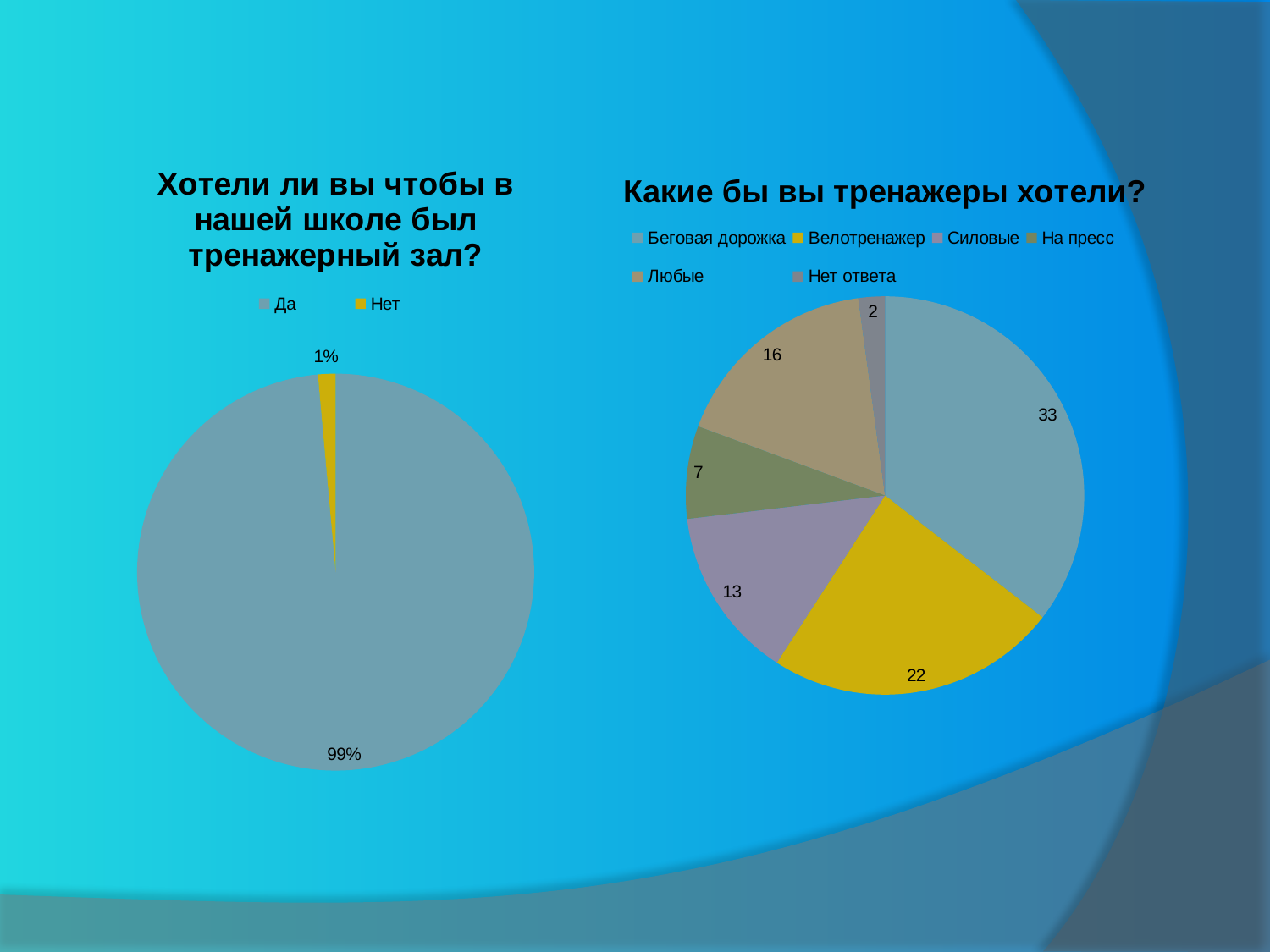
In the right chart, what is the difference between the values for "Беговая дорожка" and "Силовые"? 20 In the chart titled "Какие бы вы тренажеры хотели?", what is the value for "Велотренажер"? 22 In the chart titled "Какие бы вы тренажеры хотели?", what is the value for "Беговая дорожка"? 33 In the right chart, which category has the highest value? Беговая дорожка In the chart titled "Какие бы вы тренажеры хотели?", what is the value for "Любые"? 16 In the chart titled "Хотели ли вы чтобы в нашей школе был тренажерный зал?", what percentage answered "Нет"? 1% In the left chart, what share of the pie does the "Да" slice take? 99% In the right chart, which category has the lowest value? Нет ответа In the chart titled "Хотели ли вы чтобы в нашей школе был тренажерный зал?", what percentage answered "Да"? 99% How many categories does the legend of the right chart list? 6 What kind of chart is the left chart on the slide? Pie chart How many series does the legend of the left chart list? 2